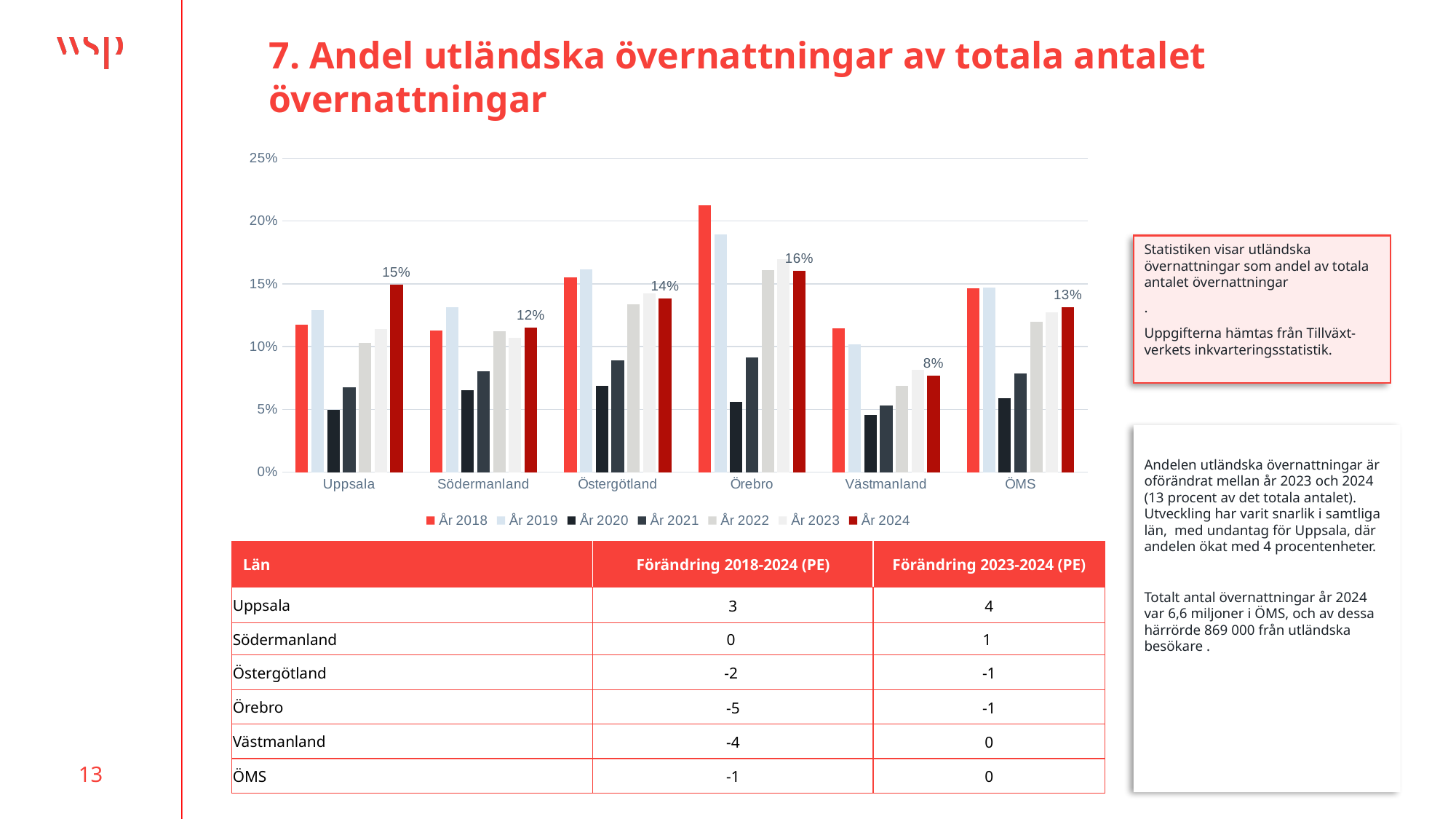
Which category has the lowest value for År 2024? Västmanland What is the value for År 2024 in Uppsala? 15% What is the value for År 2024 in Örebro? 16% How many series does the legend list? 7 Is the value for År 2018 in Örebro greater or less than 20%? greater How many categories are shown on the x axis of the chart? 6 Is the value for År 2020 in Uppsala greater or less than 10%? less Which is larger for År 2024: Östergötland or Södermanland? Östergötland What kind of chart is shown on the slide? Bar chart What is the difference between the År 2024 values for Örebro and Västmanland? 8% Which category has the highest value for År 2024? Örebro What is the value for År 2024 in Västmanland? 8%